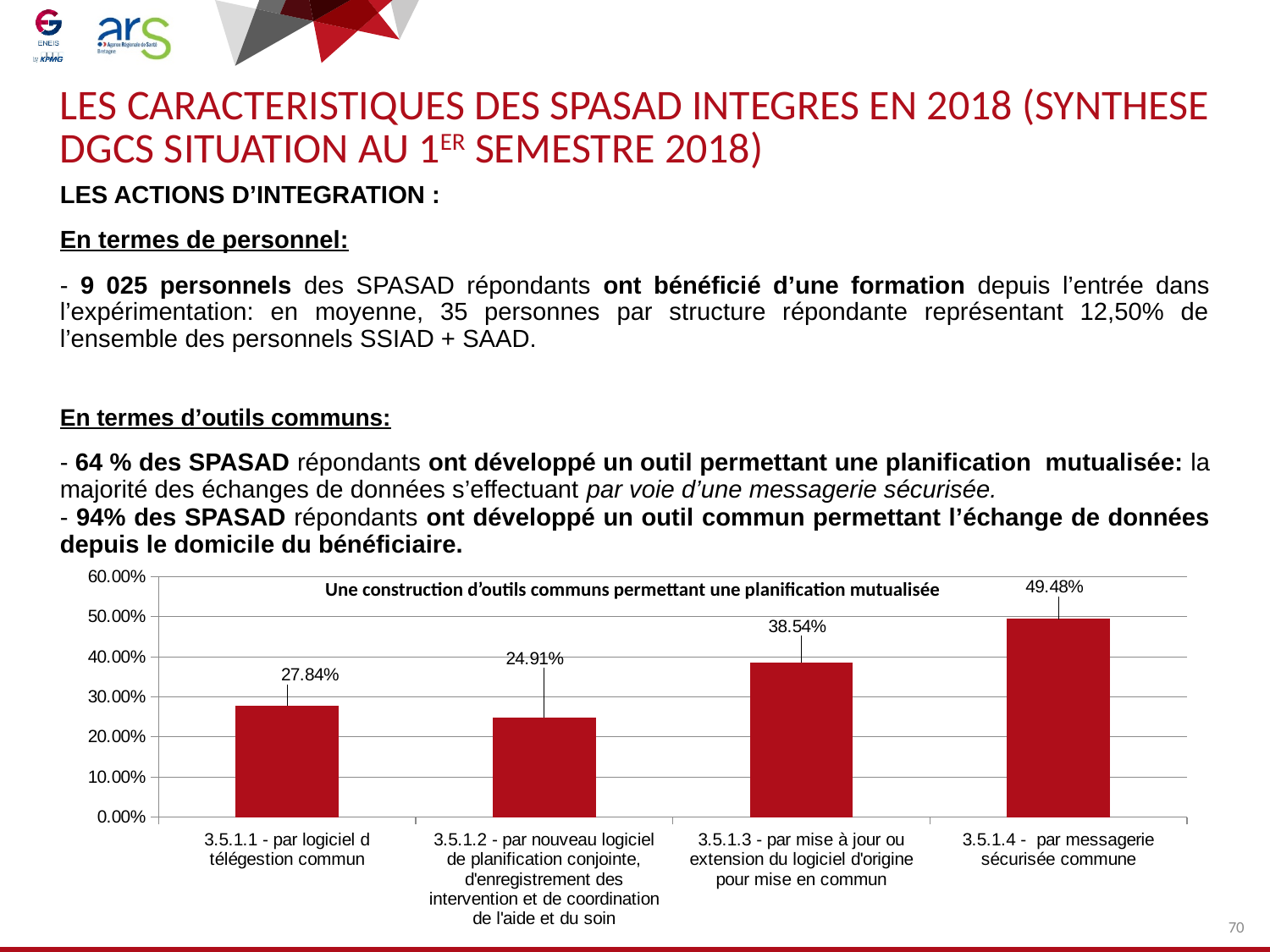
Which category has the lowest value? 3.5.1.2 - par nouveau logiciel de planification conjointe, d'enregistrement des intervention et de coordination de l'aide et du soin What kind of chart is shown on the slide? bar chart What is the value for '3.5.1.4 - par messagerie sécurisée commune'? 49.48% Which category has the highest value? 3.5.1.4 - par messagerie sécurisée commune How many categories are shown in the chart? 4 Is the value for '3.5.1.2 - par nouveau logiciel de planification conjointe, d'enregistrement des intervention et de coordination de l'aide et du soin' greater or less than 30.00%? less What is the value for '3.5.1.1 - par logiciel d télégestion commun'? 27.84% What is the difference between the values for '3.5.1.4 - par messagerie sécurisée commune' and '3.5.1.1 - par logiciel d télégestion commun'? 21.64% What is the title of the chart? Une construction d'outils communs permettant une planification mutualisée Which is larger: the value for '3.5.1.3 - par mise à jour ou extension du logiciel d'origine pour mise en commun' or the value for '3.5.1.1 - par logiciel d télégestion commun'? 3.5.1.3 - par mise à jour ou extension du logiciel d'origine pour mise en commun What is the value for '3.5.1.3 - par mise à jour ou extension du logiciel d'origine pour mise en commun'? 38.54% What is the highest value shown on the y axis of the chart? 60.00%